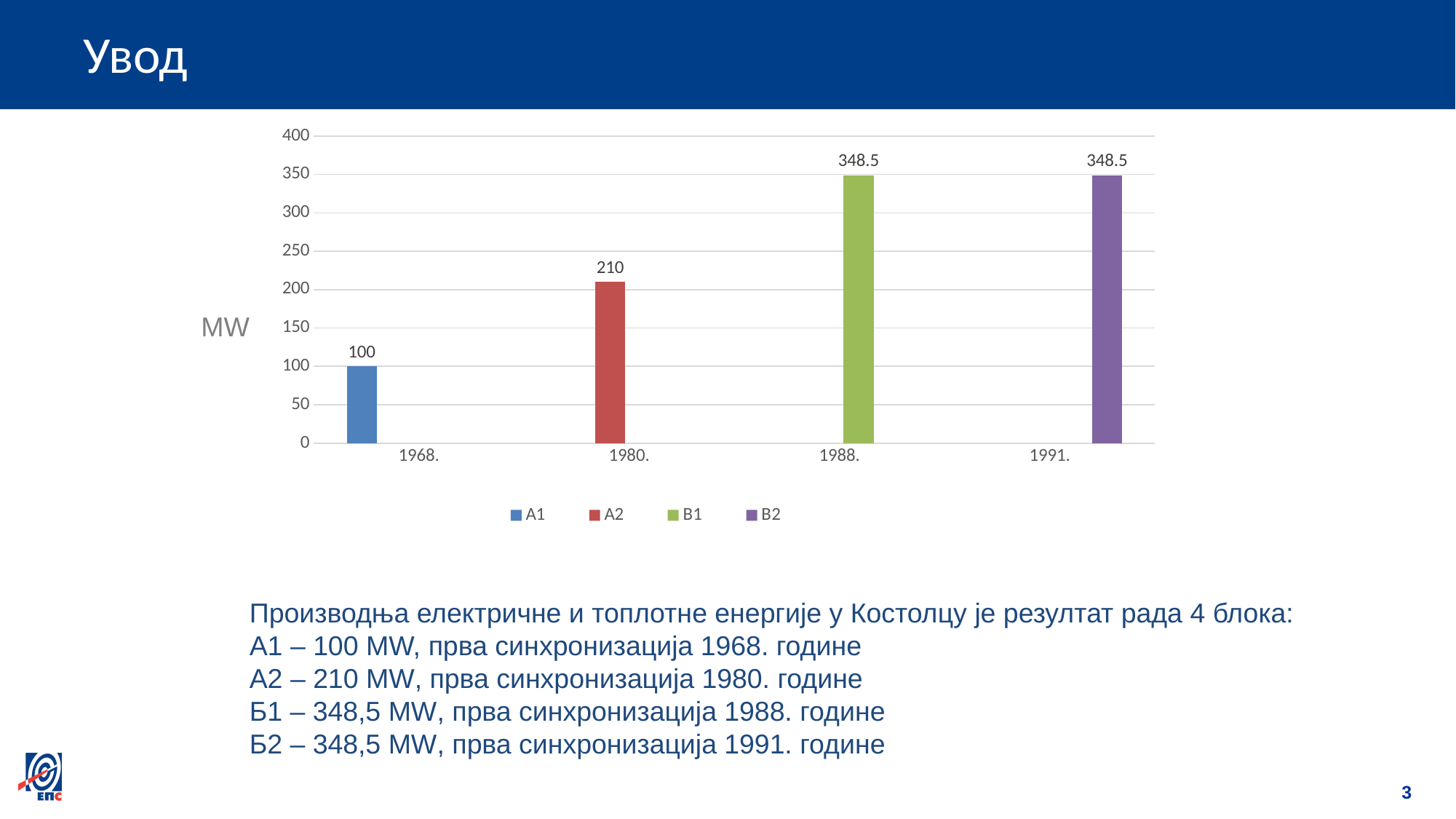
What is the value shown for 1988.? 348.5 What kind of chart is shown? bar chart How many series does the legend list? 4 Which is larger, the value for 1988. or the value for 1980.? 1988. Is the value for 1980. greater or less than 200? greater Which year has the lowest value? 1968. What is the value shown for 1980.? 210 What unit is shown on the y axis label? MW What is the value shown for 1968.? 100 What is the difference between the values for 1991. and 1980.? 138.5 How many years are shown on the x axis? 4 What is the difference between the values for 1980. and 1968.? 110